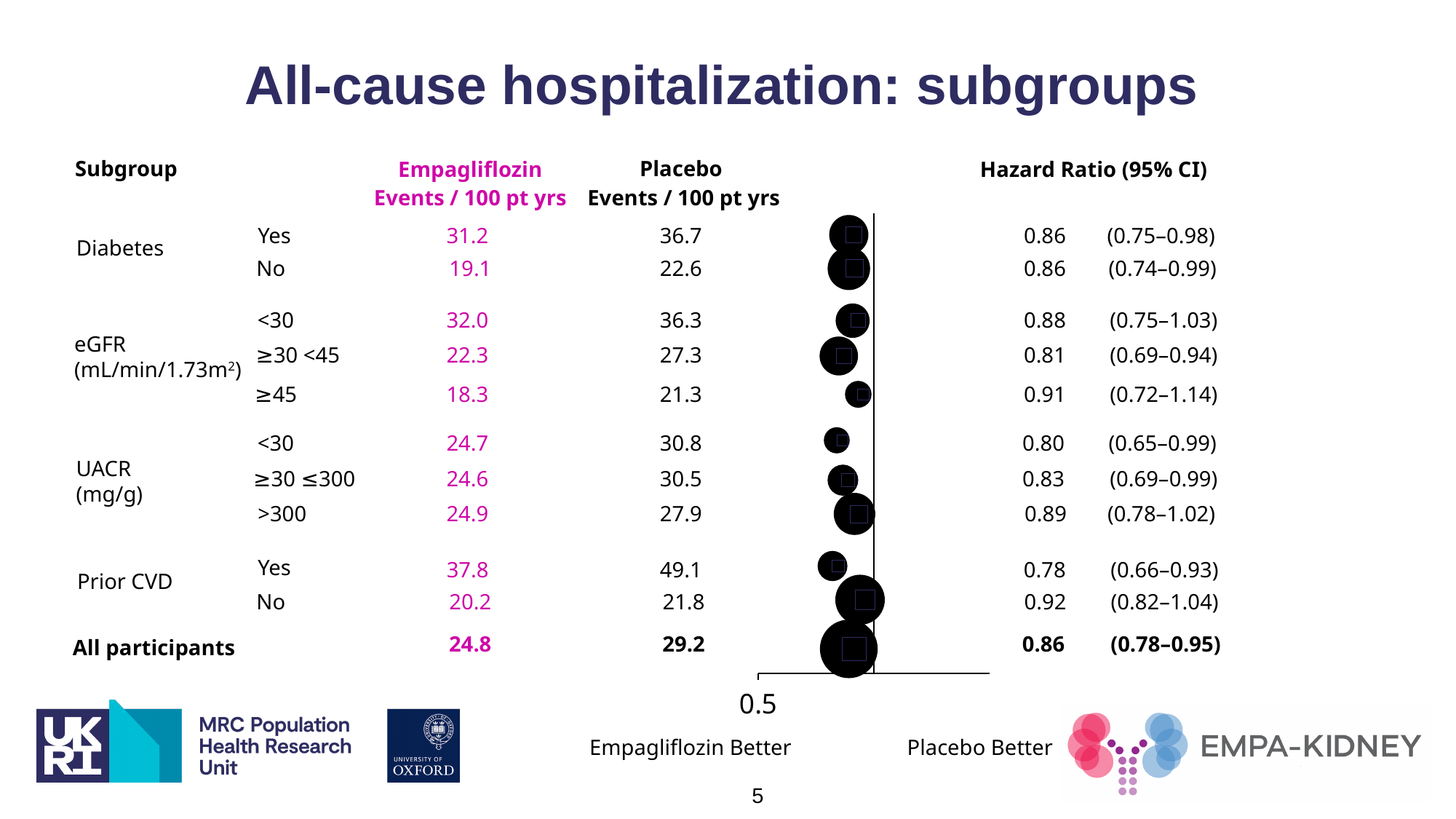
What is the Placebo events / 100 pt yrs value for the Prior CVD 'Yes' subgroup? 49.1 What is the hazard ratio for the Prior CVD 'Yes' subgroup? 0.78 What is the difference between the Placebo and Empagliflozin event rates for the Diabetes 'Yes' subgroup? 5.5 Which has a higher Empagliflozin event rate: the eGFR <30 subgroup or the UACR >300 subgroup? eGFR <30 What is the difference between the Placebo and Empagliflozin event rates for All participants? 4.4 Which subgroup has the highest hazard ratio? Prior CVD: No What is the 95% CI for the hazard ratio in All participants? (0.78–0.95) What kind of chart is shown on the slide? Forest plot What label appears on the left side below the hazard ratio axis? Empagliflozin Better What is the Empagliflozin events / 100 pt yrs value for All participants? 24.8 Which subgroup has the lowest hazard ratio? Prior CVD: Yes How many subgroup rows are shown in the plot, excluding the All participants row? 10